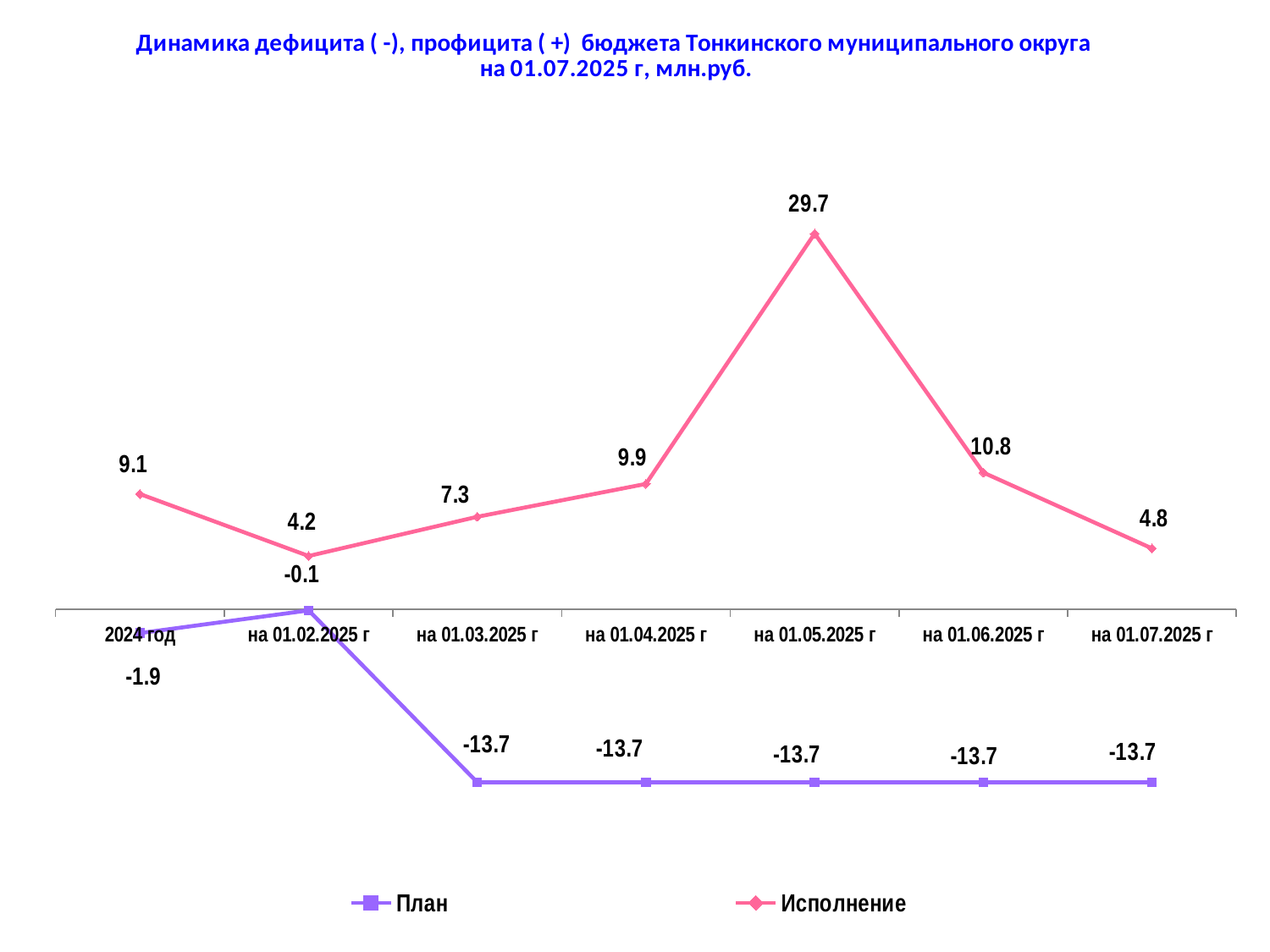
What is the value of Исполнение for 2024 год? 9.1 What is the difference between Исполнение на 01.05.2025 г and на 01.06.2025 г? 18.9 At which date does Исполнение reach its highest value? на 01.05.2025 г What is the value of Исполнение на 01.05.2025 г? 29.7 What type of chart is shown on the slide? line chart What is the value of План на 01.02.2025 г? -0.1 Does Исполнение rise or fall from на 01.05.2025 г to на 01.07.2025 г? fall What is the value of План на 01.07.2025 г? -13.7 How many series does the legend list? 2 How many points are plotted along the x axis for each series? 7 Which is larger: Исполнение на 01.04.2025 г or Исполнение на 01.03.2025 г? на 01.04.2025 г At which date is Исполнение lowest? на 01.02.2025 г